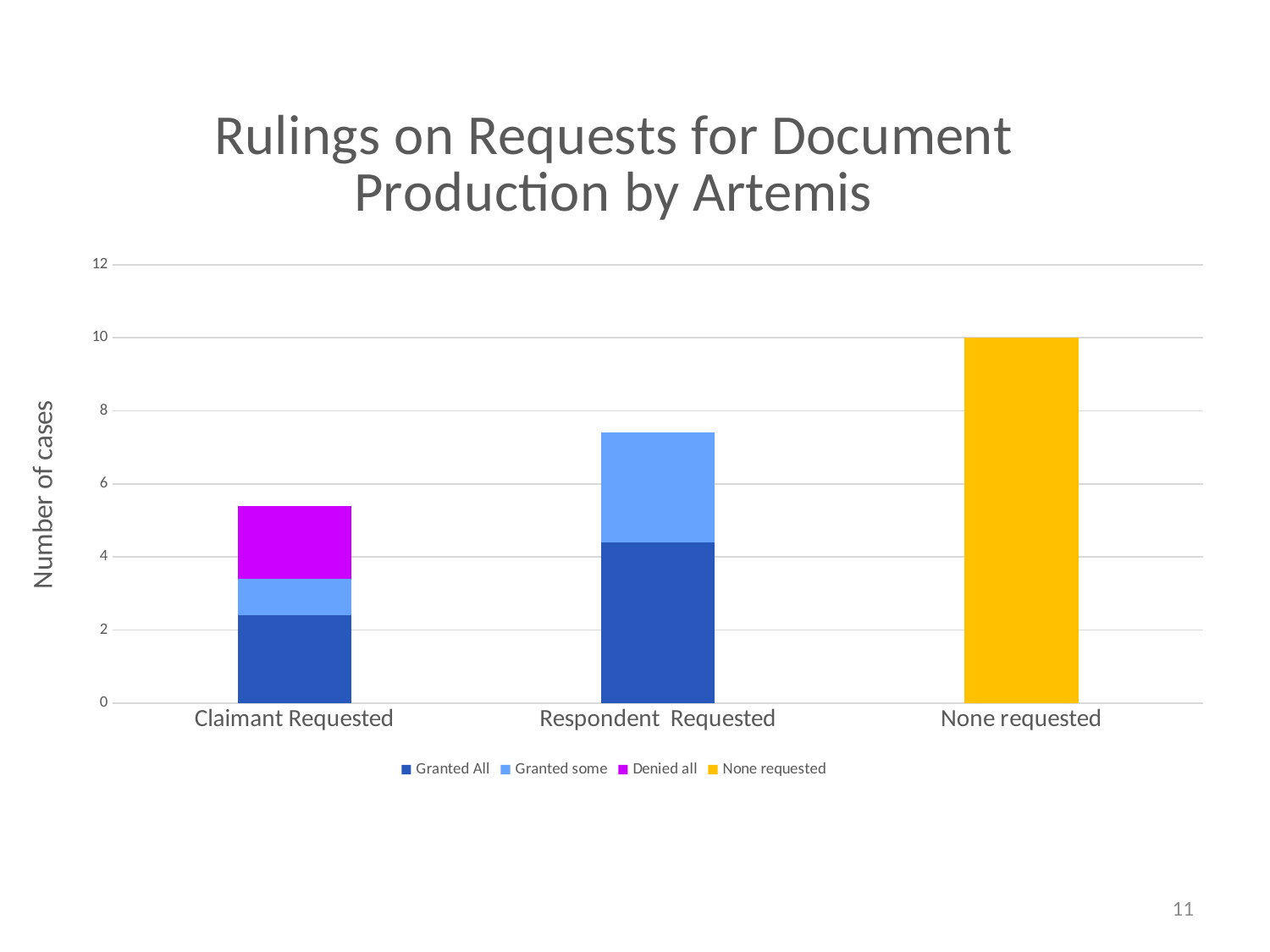
What kind of chart is shown on the slide? Stacked bar chart How many categories are shown on the x axis? 3 Which bar is taller, Claimant Requested or Respondent Requested? Respondent Requested What is the value of the None requested bar? 10 Is the total for the Respondent Requested bar greater or less than 6? greater Which category has the shortest bar? Claimant Requested What is the title of the chart? Rulings on Requests for Document Production by Artemis What is the label on the y axis? Number of cases Is the Granted All segment for Claimant Requested greater or less than 4? less Which category has the tallest bar? None requested Is the total for the Claimant Requested bar greater or less than 6? less How many series does the legend list? 4